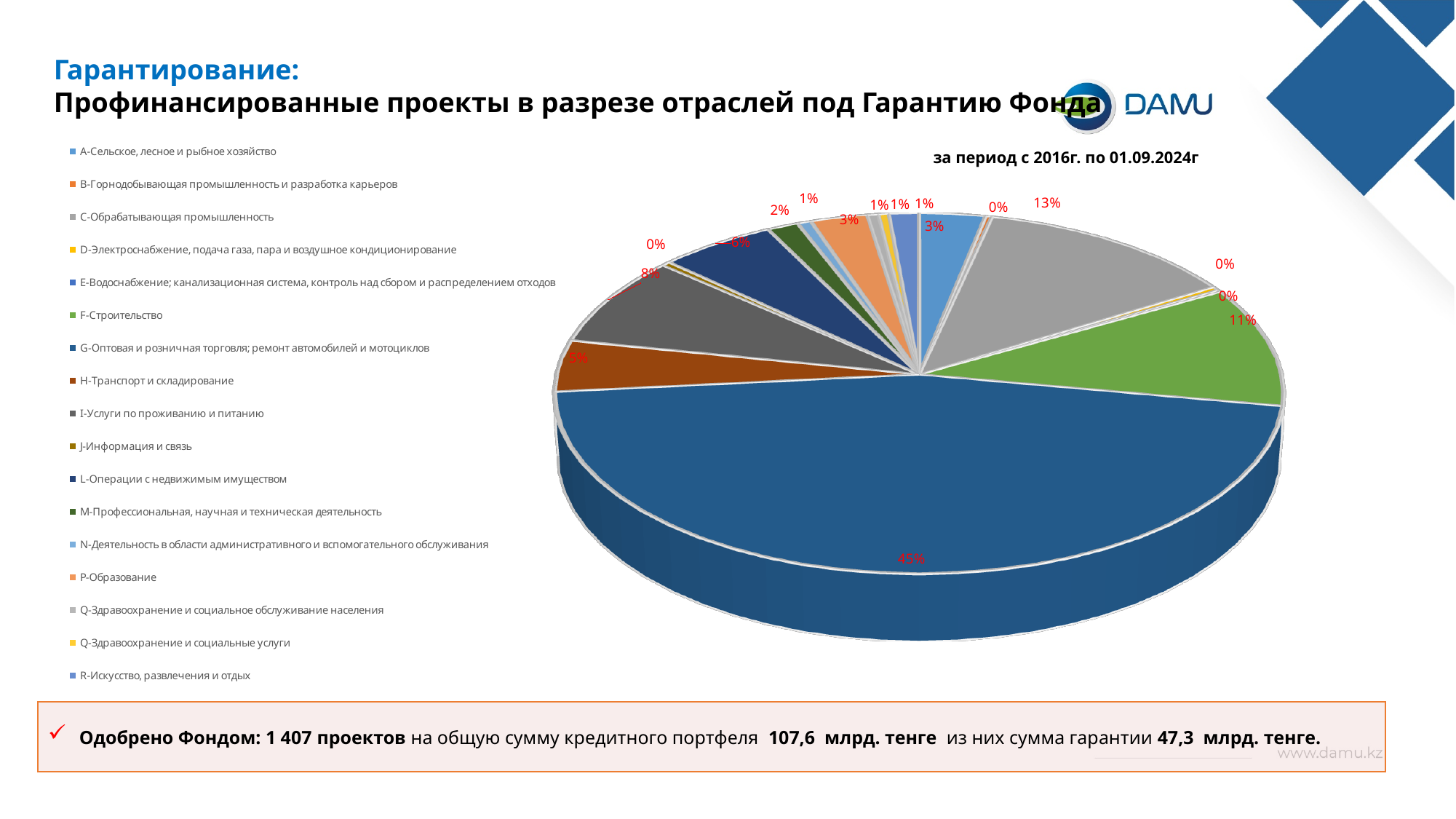
What share of the pie does G-Оптовая и розничная торговля; ремонт автомобилей и мотоциклов have? 45% Which sector has the largest share of financed projects in the pie chart? G-Оптовая и розничная торговля; ремонт автомобилей и мотоциклов What period does the chart cover, according to the text above it? за период с 2016г. по 01.09.2024г How many sectors are listed in the chart's legend? 17 What share of the pie does C-Обрабатывающая промышленность have? 13% What share of the pie does H-Транспорт и складирование have? 5% What kind of chart is shown on the slide? pie chart Which is larger: the share of C-Обрабатывающая промышленность or the share of F-Строительство? C-Обрабатывающая промышленность What colour is the largest slice of the pie chart? dark blue By how many percentage points does the share of G-Оптовая и розничная торговля exceed the share of C-Обрабатывающая промышленность? 32 percentage points